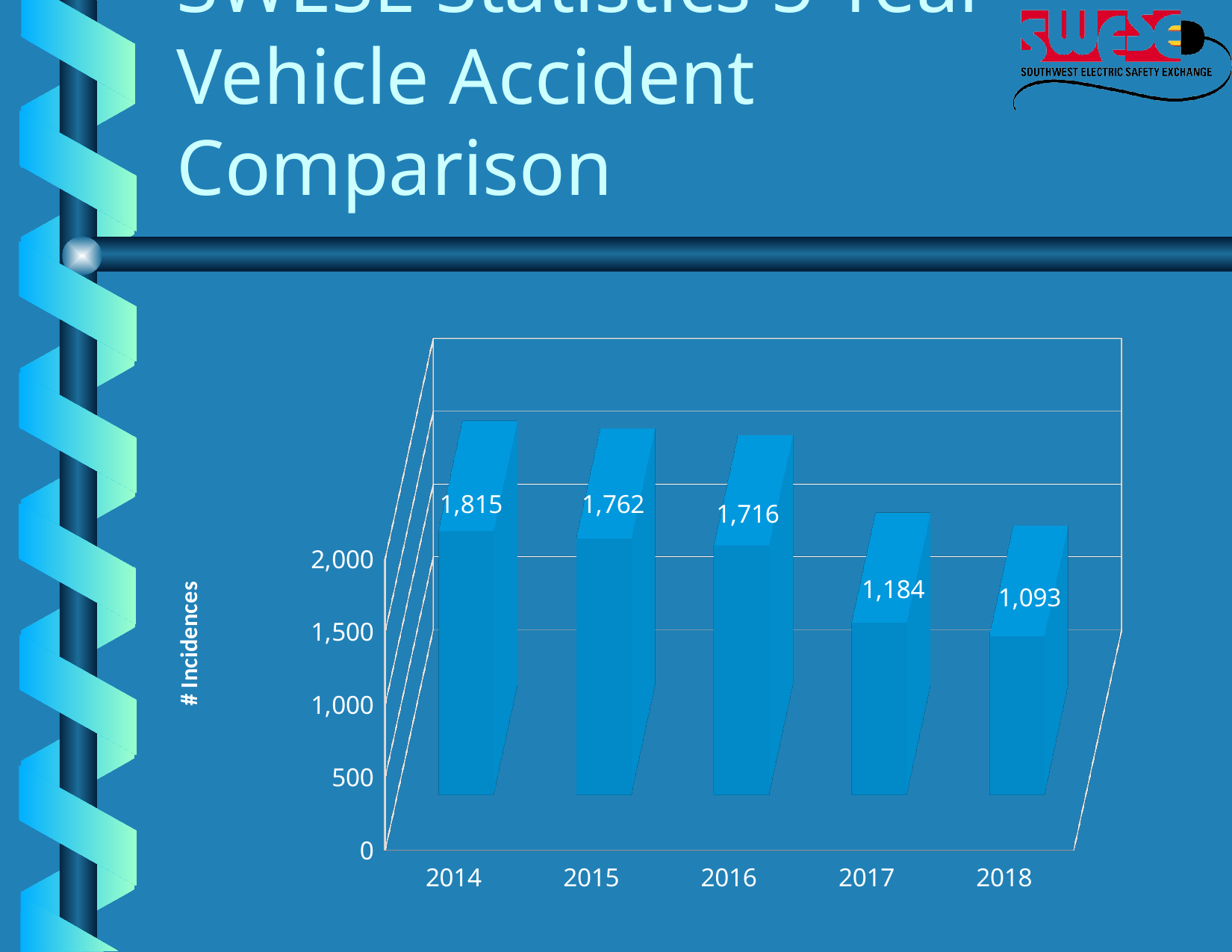
Which year has the highest number of incidences? 2014 What is the difference in incidences between 2014 and 2018? 722 Which year has more incidences, 2015 or 2016? 2015 Which year has the lowest number of incidences? 2018 What kind of chart is shown on the slide? Bar chart What is the difference in incidences between 2016 and 2017? 532 What is the label on the vertical axis of the chart? # Incidences What is the number of incidences for 2017? 1,184 What is the number of incidences for 2018? 1,093 What is the number of incidences for 2014? 1,815 How many years are shown on the x axis? 5 Do the number of incidences rise or fall from 2014 to 2018? Fall